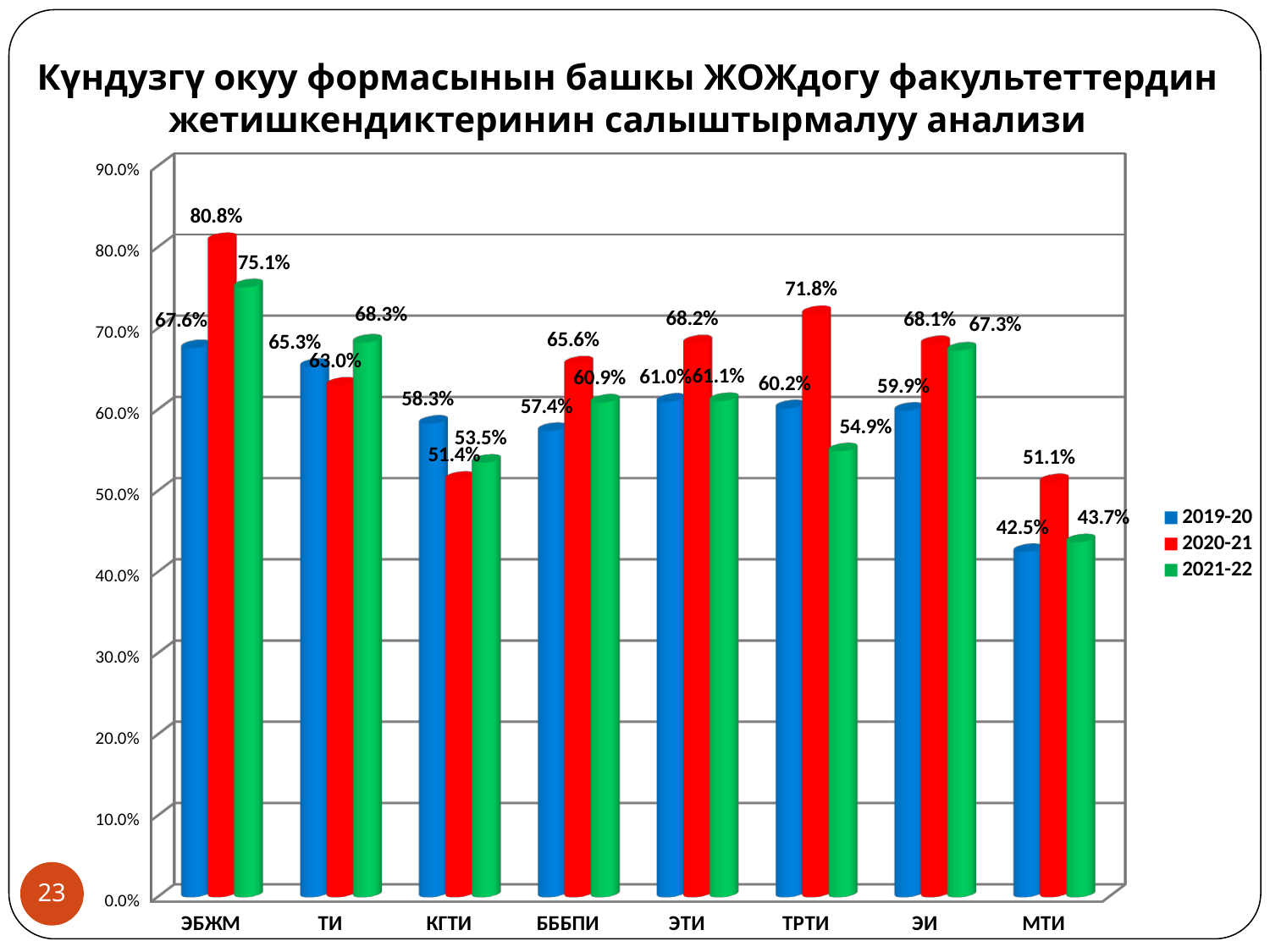
Which category has the lowest value in the 2019-20 series? МТИ What is the difference between the 2020-21 and 2019-20 values for ТРТИ? 11.6% What is the value for ЭБЖМ in the 2020-21 series? 80.8% Which category has the highest value in the 2020-21 series? ЭБЖМ What is the value for ТРТИ in the 2021-22 series? 54.9% Which is larger for ТИ: the 2019-20 value or the 2020-21 value? 2019-20 What is the value for МТИ in the 2019-20 series? 42.5% What kind of chart is shown on the slide? bar chart How many categories are shown on the x axis? 8 Is the 2021-22 value for КГТИ greater or less than 60.0%? less Which colour represents the 2021-22 series in the legend? green How many series does the legend list? 3